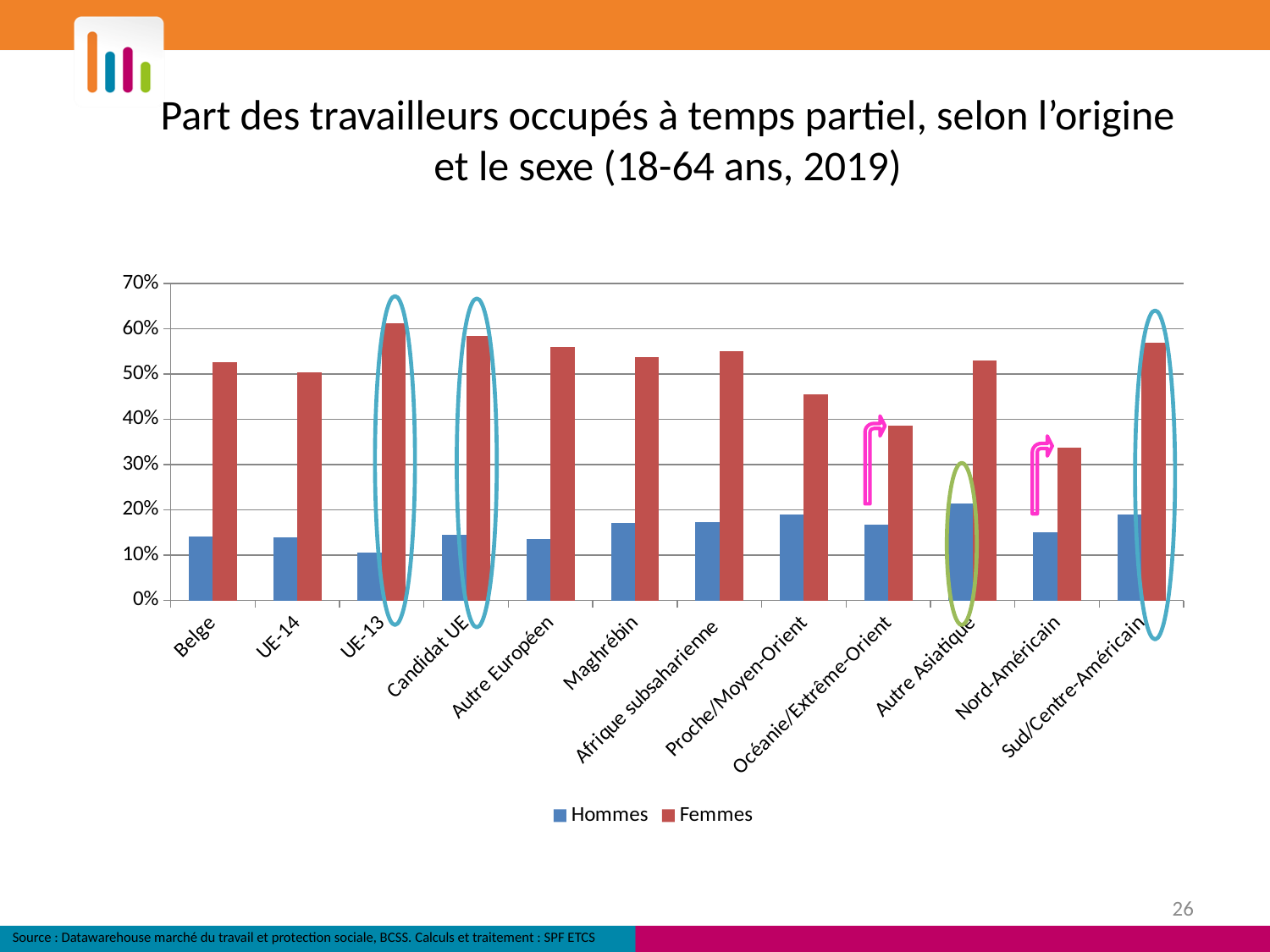
Is the Femmes value for Proche/Moyen-Orient greater or less than 50%? less Is the Femmes value for Nord-Américain greater or less than 40%? less What kind of chart is shown on the slide? bar chart Which series is shown in blue in the legend? Hommes Which origin category has the lowest value for Hommes? UE-13 Is the Hommes value for Belge greater or less than 10%? greater How many origin categories are shown on the x axis? 12 Which origin category has the lowest value for Femmes? Nord-Américain For Belge, which series has the larger value, Hommes or Femmes? Femmes Which origin category has the highest value for Femmes? UE-13 How many series does the legend list? 2 Which origin category has the highest value for Hommes? Autre Asiatique